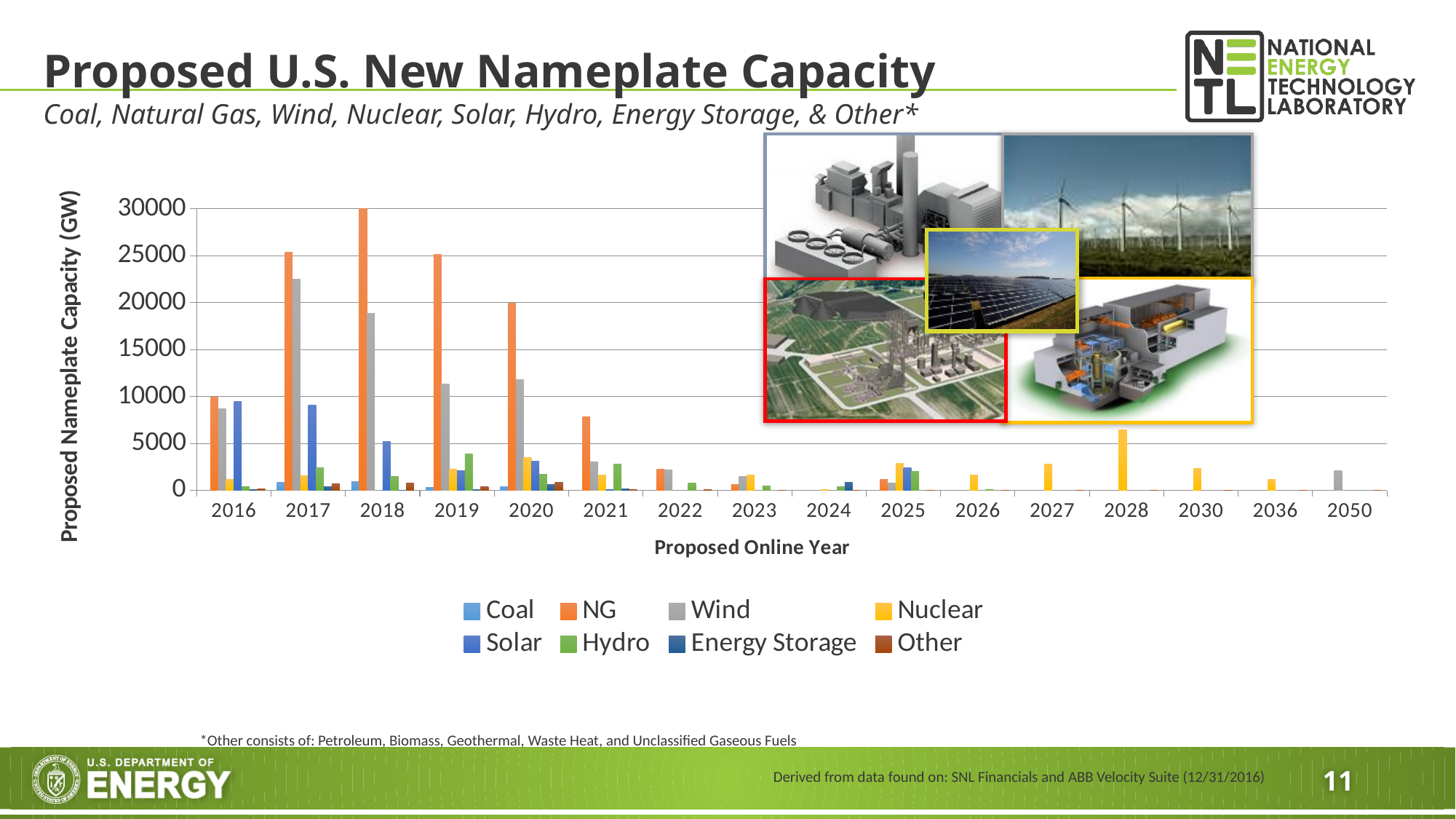
How many series does the legend list? 8 Is the value for NG in 2017 greater or less than 20000? greater How many proposed online years are shown on the x axis? 16 In which year is the Nuclear bar the tallest? 2028 Is the value for Hydro in 2019 greater or less than 5000? less Does the NG series rise or fall from 2018 to 2021? fall In which year is the NG bar the tallest? 2018 Which is larger in 2016, the NG bar or the Wind bar? NG What is the title of the x axis? Proposed Online Year Is the value for Wind in 2018 greater or less than 20000? less What kind of chart is shown on the slide? bar chart